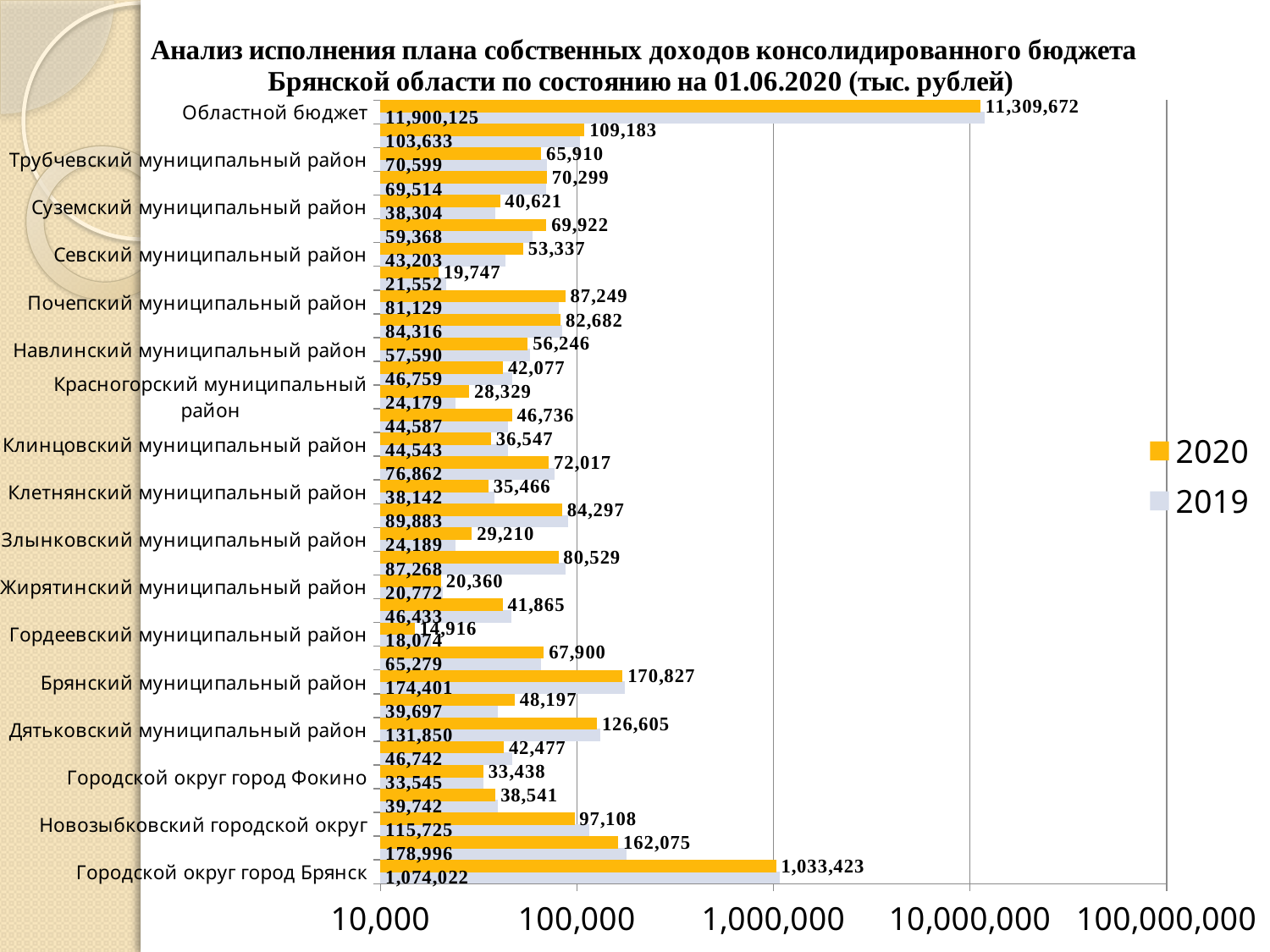
Is the 2020 value for Дятьковский муниципальный район greater or less than 100,000? greater What is the difference between the 2019 and 2020 values for Областной бюджет? 590,453 Which category has the highest 2020 value? Областной бюджет How many series does the legend list? 2 What is the 2020 value for Областной бюджет? 11,309,672 What type of chart is shown on the slide? Bar chart What is the difference between the 2020 and 2019 values for Севский муниципальный район? 10,134 What is the 2020 value for Новозыбковский городской округ? 97,108 What is the 2019 value for Городской округ город Брянск? 1,074,022 For Злынковский муниципальный район, which is larger: the 2020 value or the 2019 value? 2020 What is the 2019 value for Клинцовский муниципальный район? 44,543 Which category has the lowest 2020 value? Гордеевский муниципальный район